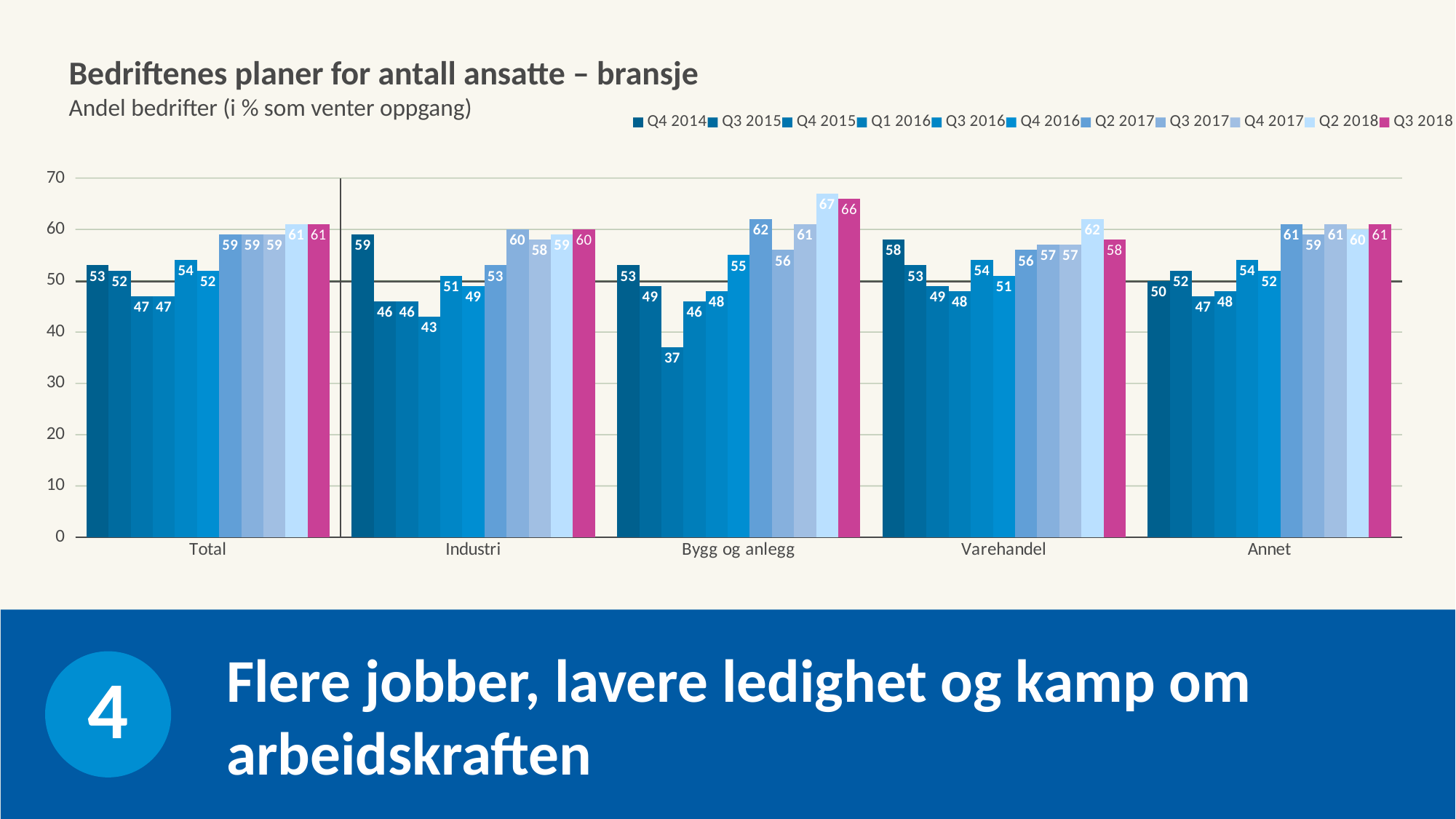
What is the title of the chart? Bedriftenes planer for antall ansatte – bransje What is the value for Bygg og anlegg in Q3 2018? 66 What kind of chart is shown on the slide? Bar chart How many series does the legend list? 11 What is the difference between the Q2 2018 and Q4 2015 values for Bygg og anlegg? 30 What is the value for Industri in Q1 2016? 43 Which quarter has the lowest value for Bygg og anlegg? Q4 2015 Which category has the highest value in Q3 2018? Bygg og anlegg Which is larger in Q3 2018: the value for Total or the value for Varehandel? Total What is the value for Industri in Q4 2014? 59 How many categories are shown on the x axis? 5 What is the difference between the Q3 2018 and Q4 2014 values for Total? 8